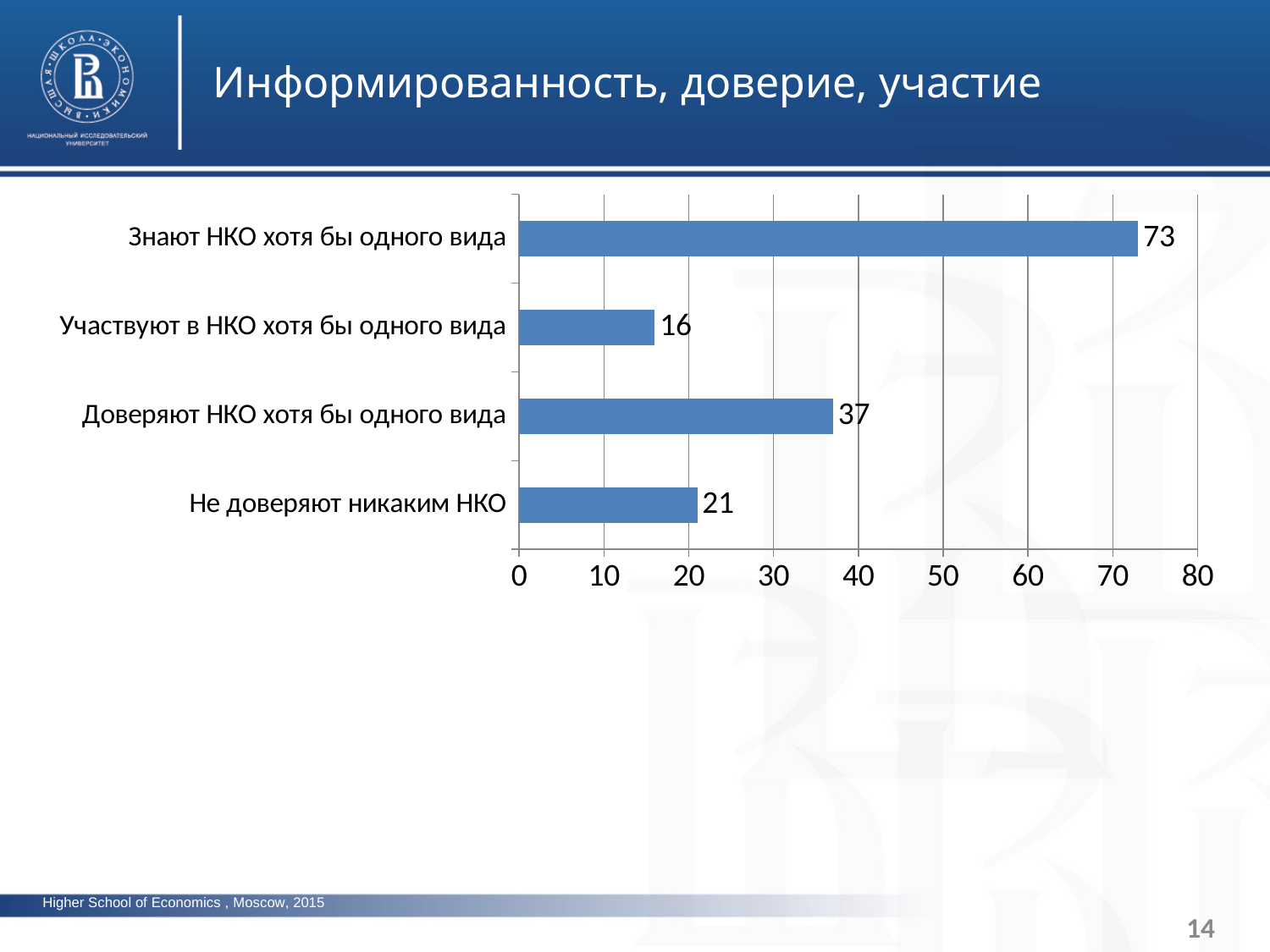
How many categories are shown in the chart? 4 Which is larger: the value for "Доверяют НКО хотя бы одного вида" or "Не доверяют никаким НКО"? Доверяют НКО хотя бы одного вида What is the value for "Доверяют НКО хотя бы одного вида"? 37 What is the difference between the values for "Не доверяют никаким НКО" and "Участвуют в НКО хотя бы одного вида"? 5 What is the value for "Знают НКО хотя бы одного вида"? 73 Which category has the highest value? Знают НКО хотя бы одного вида What kind of chart is shown on the slide? bar chart What is the value for "Не доверяют никаким НКО"? 21 Is the value for "Знают НКО хотя бы одного вида" greater or less than 70? greater What is the value for "Участвуют в НКО хотя бы одного вида"? 16 Which category has the lowest value? Участвуют в НКО хотя бы одного вида What is the difference between the values for "Знают НКО хотя бы одного вида" and "Доверяют НКО хотя бы одного вида"? 36